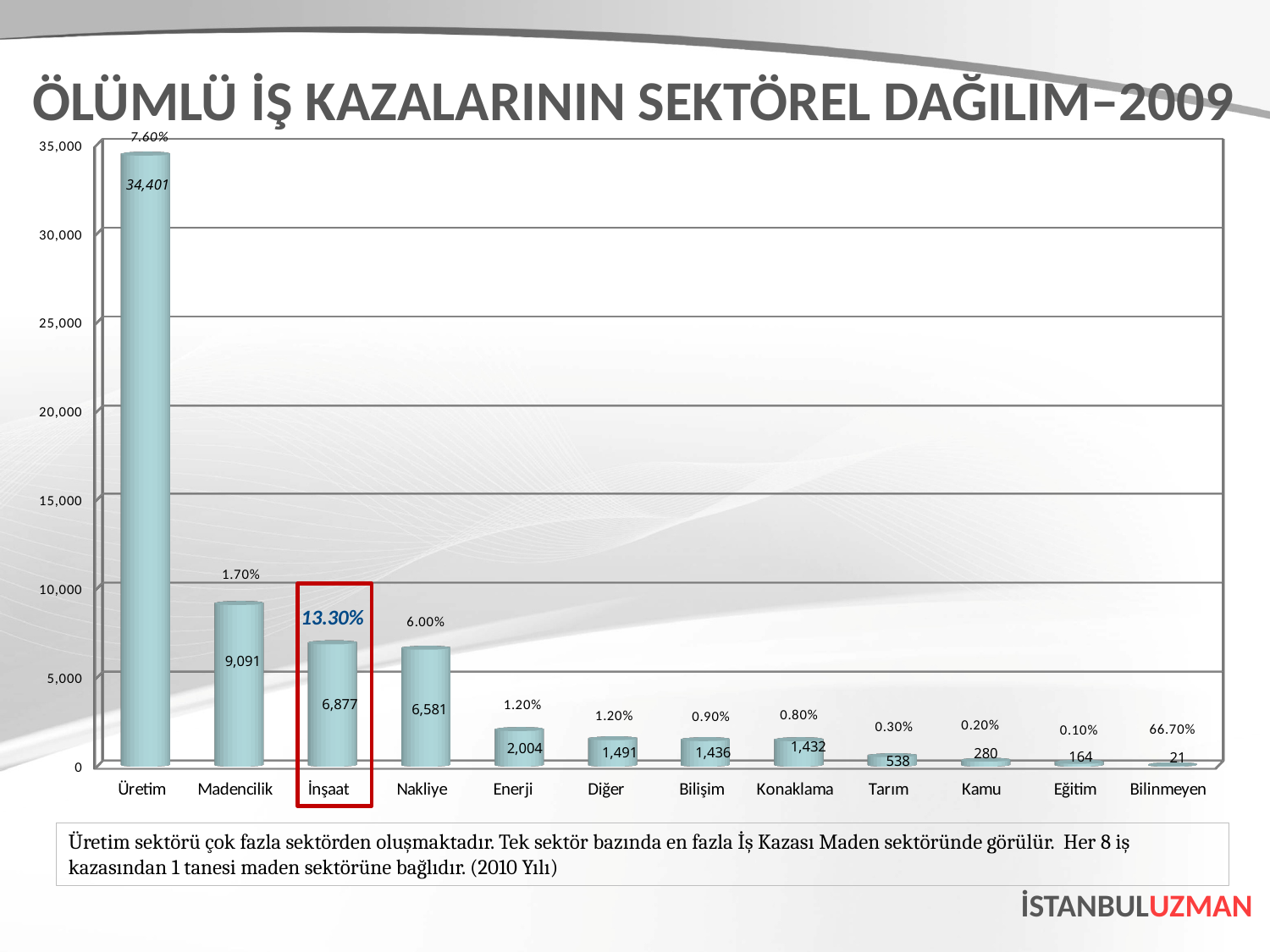
Which category's bar is outlined with a red box? İnşaat What is the value for Nakliye? 6,581 What percentage is shown above the İnşaat bar? 13.30% What is the value for Üretim? 34,401 Which is larger, the value for Madencilik or the value for Nakliye? Madencilik Which category has the lowest value? Bilinmeyen What is the difference between the values for Madencilik and İnşaat? 2,214 What is the value for Madencilik? 9,091 Which category has the highest value? Üretim What is the value for Bilinmeyen? 21 What kind of chart is shown on the slide? Bar chart How many categories are shown on the x axis? 12